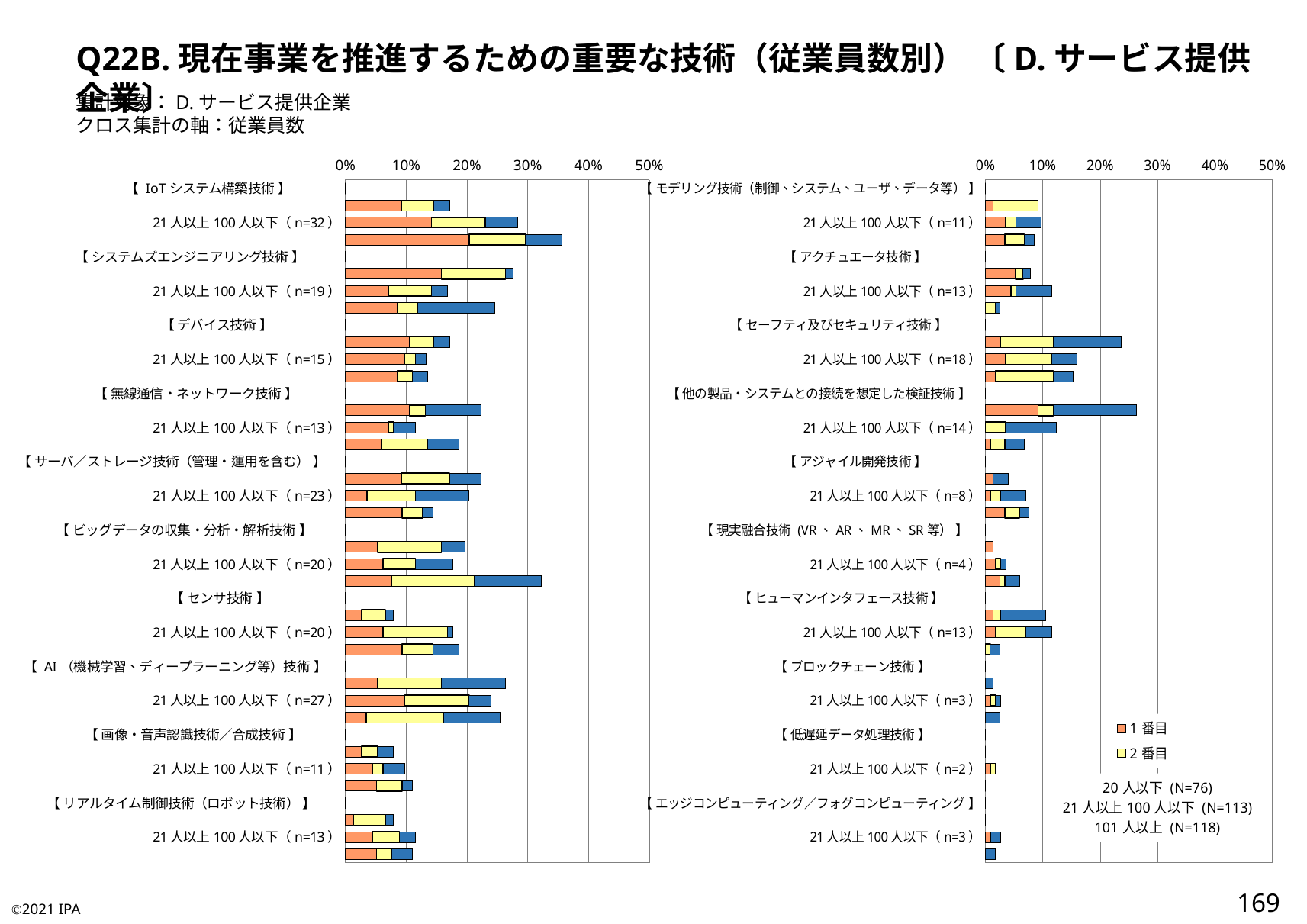
In the left chart, is the total bar for 101人以上 under 【IoTシステム構築技術】 greater or less than 30%? greater In the left chart, is the total bar for 20人以下 under 【IoTシステム構築技術】 greater or less than 20%? less In the left chart, is the total bar for 101人以上 under 【ビッグデータの収集・分析・解析技術】 greater or less than 30%? greater What kind of chart is used on this slide? bar chart In the left chart, under 【IoTシステム構築技術】, which has the longer total bar: 20人以下 or 101人以上? 101人以上 Which colour represents 1番目 in the legend? orange What is the maximum value shown on the horizontal axis of the charts? 50% How many technology categories are listed in the left chart? 10 In the right chart, under 【セーフティ及びセキュリティ技術】, which has the longer total bar: 20人以下 or 21人以上100人以下 (n=18)? 20人以下